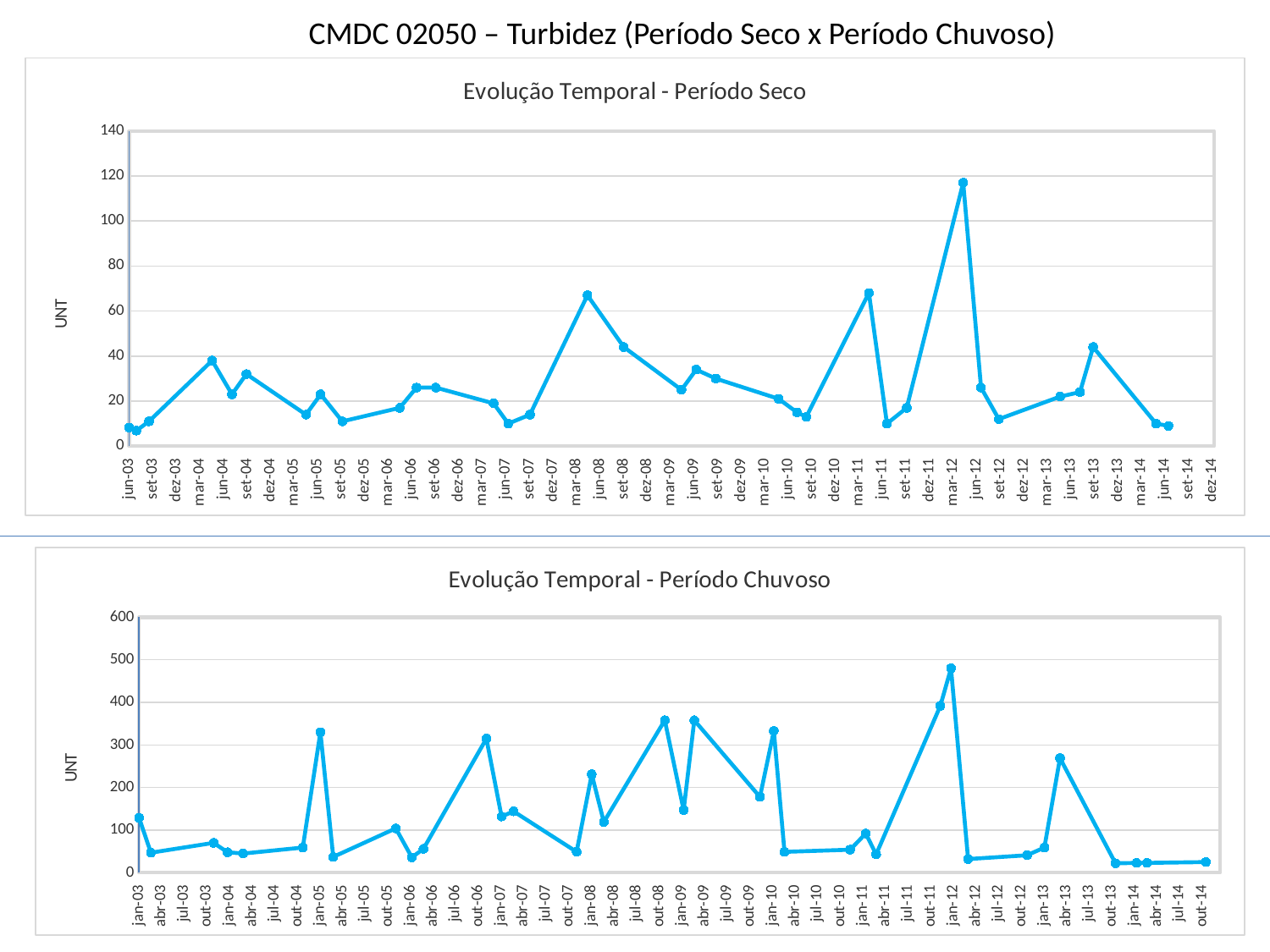
In the bottom chart 'Evolução Temporal - Período Chuvoso', in which year does the highest point of the line occur? 2012 In the bottom chart 'Evolução Temporal - Período Chuvoso', is the first point (jan-03) greater or less than 200? less In the top chart 'Evolução Temporal - Período Seco', is the first point (jun-03) greater or less than 20? less What kind of chart is the top chart, 'Evolução Temporal - Período Seco'? line chart In the top chart 'Evolução Temporal - Período Seco', which is higher: the peak in 2011 or the peak in 2012? the peak in 2012 In the top chart 'Evolução Temporal - Período Seco', what is the highest value shown on the y axis? 140 In the bottom chart 'Evolução Temporal - Período Chuvoso', what is the highest value shown on the y axis? 600 What kind of chart is the bottom chart, 'Evolução Temporal - Período Chuvoso'? line chart In the top chart 'Evolução Temporal - Período Seco', is the highest point on the line greater or less than 100? greater In the top chart 'Evolução Temporal - Período Seco', in which year does the highest point of the line occur? 2012